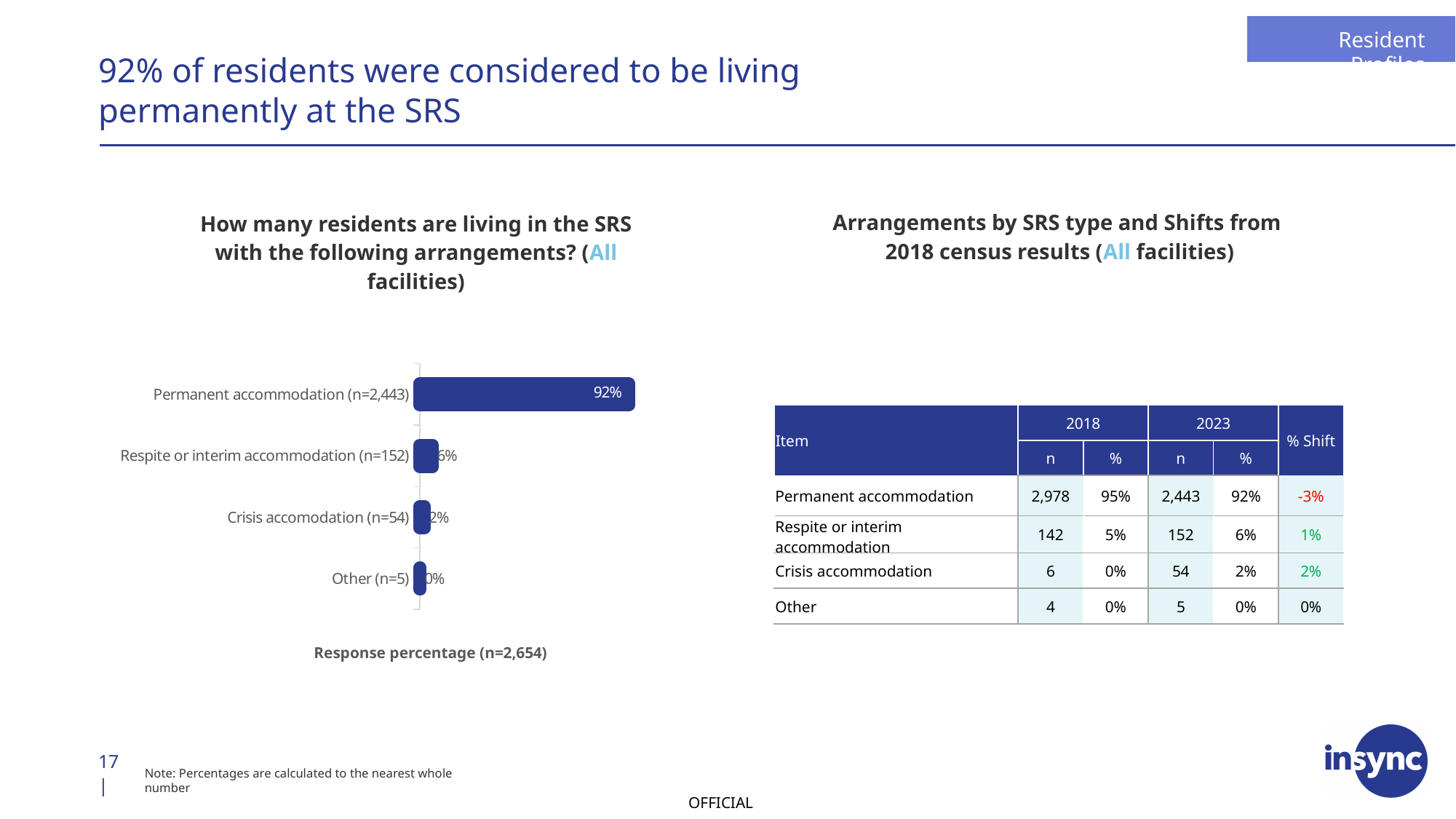
What is the difference in response percentage between Permanent accommodation and Respite or interim accommodation? 86% What is the response percentage for Other (n=5)? 0% Which category has the highest response percentage? Permanent accommodation (n=2,443) What is the title of the bar chart? How many residents are living in the SRS with the following arrangements? (All facilities) What is the response percentage for Permanent accommodation (n=2,443)? 92% Which has a larger response percentage, Respite or interim accommodation or Crisis accomodation? Respite or interim accommodation Which category has the lowest response percentage? Other (n=5) How many categories does the bar chart show? 4 What is the x-axis label of the bar chart? Response percentage (n=2,654) What is the response percentage for Crisis accomodation (n=54)? 2% What kind of chart is shown on the slide? bar chart What is the response percentage for Respite or interim accommodation (n=152)? 6%